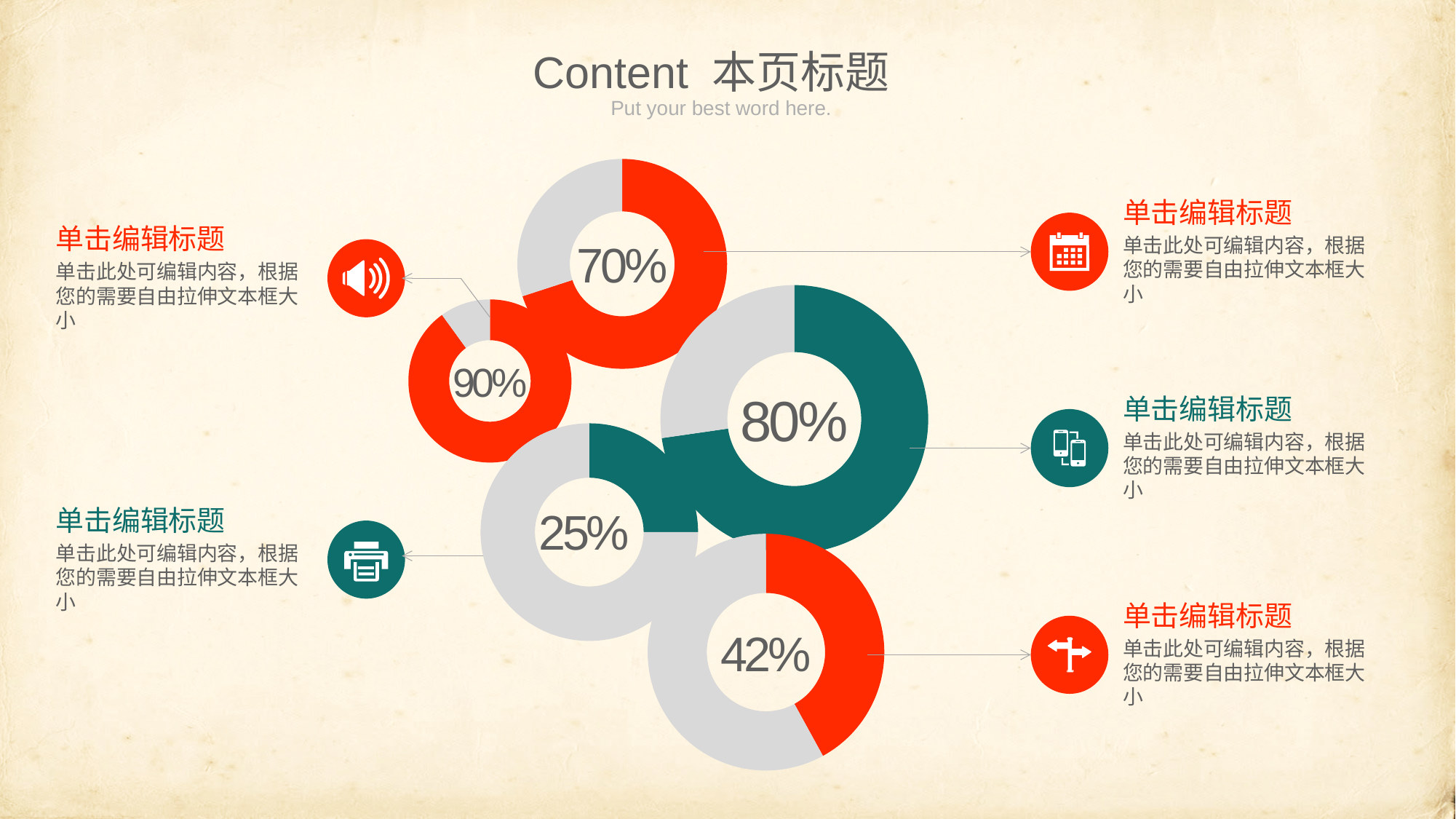
What kind of chart is used for the percentages on the slide? Donut (pie) chart Which donut chart shows the lowest percentage? The bottom-left donut, 25% Which donut chart shows the highest percentage? The small left donut, 90% What value is printed in the small donut chart on the far left? 90% Which is larger, the value in the top donut chart or the value in the bottom-right donut chart? The top donut chart (70%) What colour is the filled portion of the 80% donut chart? Teal green What value is printed in the bottom-right donut chart? 42% What value is printed in the largest donut chart, the teal one on the right? 80% What is the difference between the highest percentage (90%) and the lowest percentage (25%) shown on the slide? 65% What value is printed in the bottom-left donut chart? 25% How many donut charts are shown on the slide? 5 What value is printed in the topmost donut chart? 70%